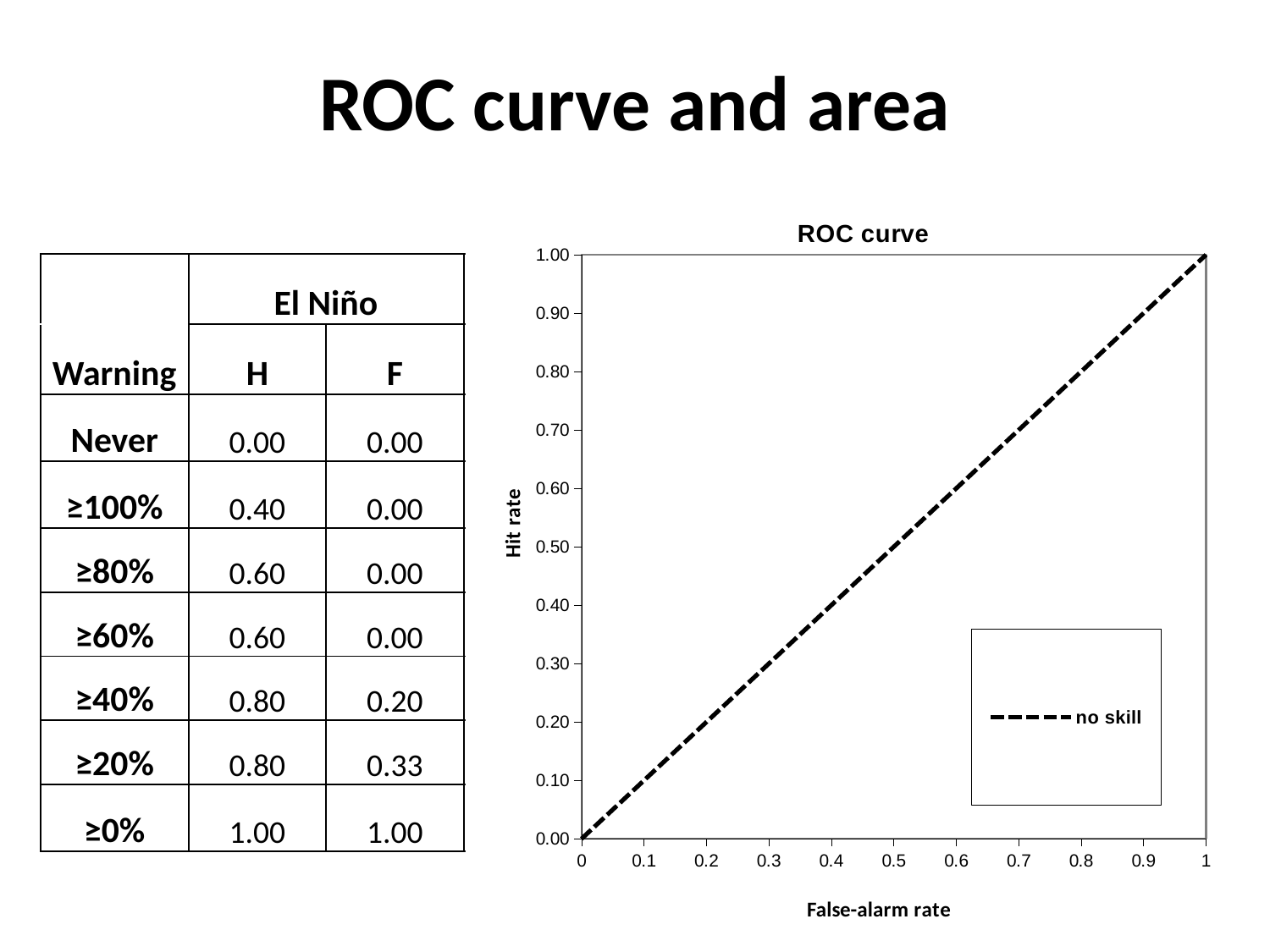
In the ROC curve chart, is the hit rate of the no skill line at a false-alarm rate of 0.2 greater or less than 0.40? less What is the title of the chart on the slide? ROC curve In the ROC curve chart, what is the hit rate of the no skill line at a false-alarm rate of 1? 1.00 In the ROC curve chart, what is the difference between the hit rate of the no skill line at a false-alarm rate of 1 and at 0? 1.00 In the ROC curve chart, what is the hit rate of the no skill line at a false-alarm rate of 0? 0.00 In the ROC curve chart, which is larger: the hit rate of the no skill line at a false-alarm rate of 0.3 or at 0.7? 0.7 How many series does the legend of the ROC curve chart list? 1 What kind of chart is the ROC curve chart? line chart In the ROC curve chart, is the hit rate of the no skill line at a false-alarm rate of 0.8 greater or less than 0.60? greater In the ROC curve chart, does the no skill line rise or fall as the false-alarm rate increases? rises What is the name of the series shown in the legend of the ROC curve chart? no skill